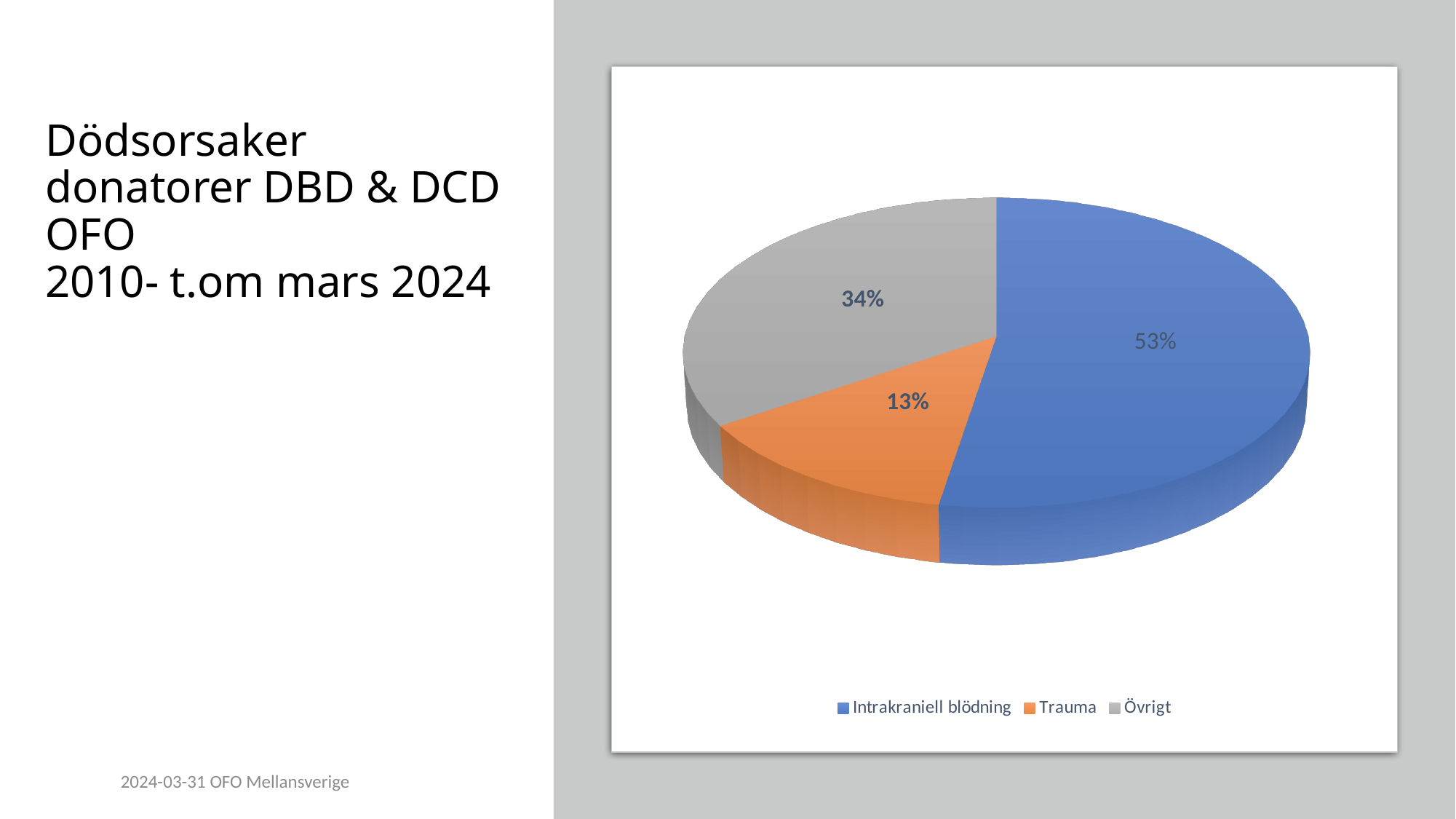
What is the difference in percentage points between Intrakraniell blödning and Övrigt? 19 Which colour represents Trauma in the pie chart? Orange Which is larger, the share for Trauma or the share for Övrigt? Övrigt Which category has the largest slice of the pie? Intrakraniell blödning What share of the pie does Intrakraniell blödning account for? 53% What are the three legend entries of the chart? Intrakraniell blödning, Trauma, Övrigt Which category has the smallest slice of the pie? Trauma What is the difference in percentage points between Övrigt and Trauma? 21 What share of the pie does Trauma account for? 13% What share of the pie does Övrigt account for? 34% What kind of chart is shown on the slide? Pie chart How many categories are shown in the pie chart? 3